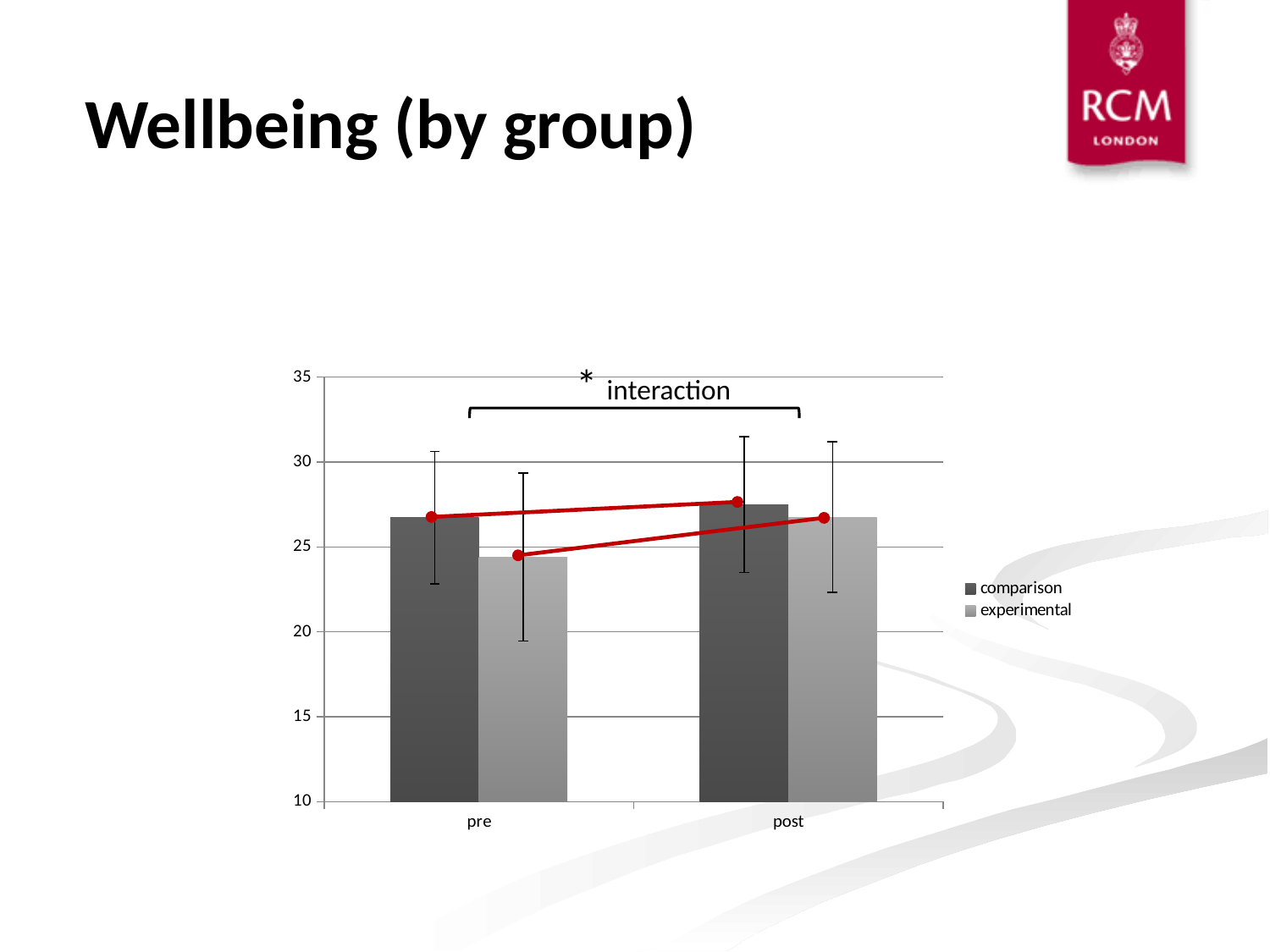
How many categories are shown on the x axis? 2 What are the two series named in the legend? comparison and experimental Is the value for the comparison group at post greater or less than 30? less Is the value for the experimental group at post greater or less than 25? greater Which bar is the lowest in the chart? experimental at pre Is the value for the comparison group at pre greater or less than 25? greater What word is written above the bracket at the top of the chart? interaction What kind of chart is shown on the slide? bar chart At pre, which group has the larger value, comparison or experimental? comparison Does the experimental group's value rise or fall from pre to post? rise How many series does the legend list? 2